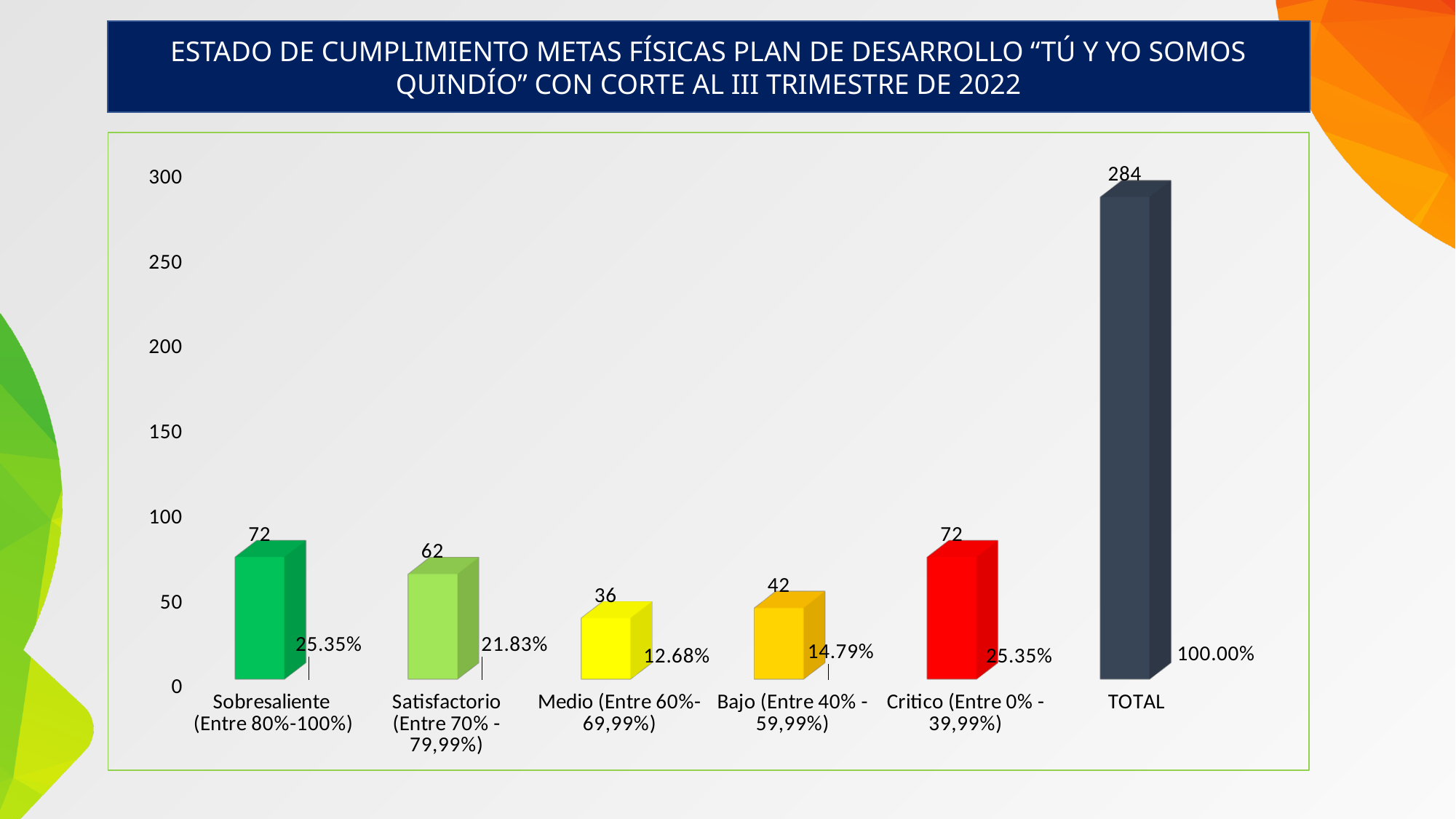
What is the difference between the values for Satisfactorio and Bajo? 20 What is the value for Medio (Entre 60%-69,99%)? 36 What is the value for Sobresaliente (Entre 80%-100%)? 72 What kind of chart is shown on the slide? Bar chart What colour is the bar for Critico (Entre 0% - 39,99%)? Red What percentage is shown for Satisfactorio (Entre 70% - 79,99%)? 21.83% How many categories are shown on the x axis? 6 Which is larger, the value for Bajo (Entre 40% - 59,99%) or the value for Medio (Entre 60%-69,99%)? Bajo (Entre 40% - 59,99%) What is the value for TOTAL? 284 What percentage is shown for Bajo (Entre 40% - 59,99%)? 14.79% Which bar is the tallest in the chart? TOTAL Excluding TOTAL, which category has the lowest value? Medio (Entre 60%-69,99%)